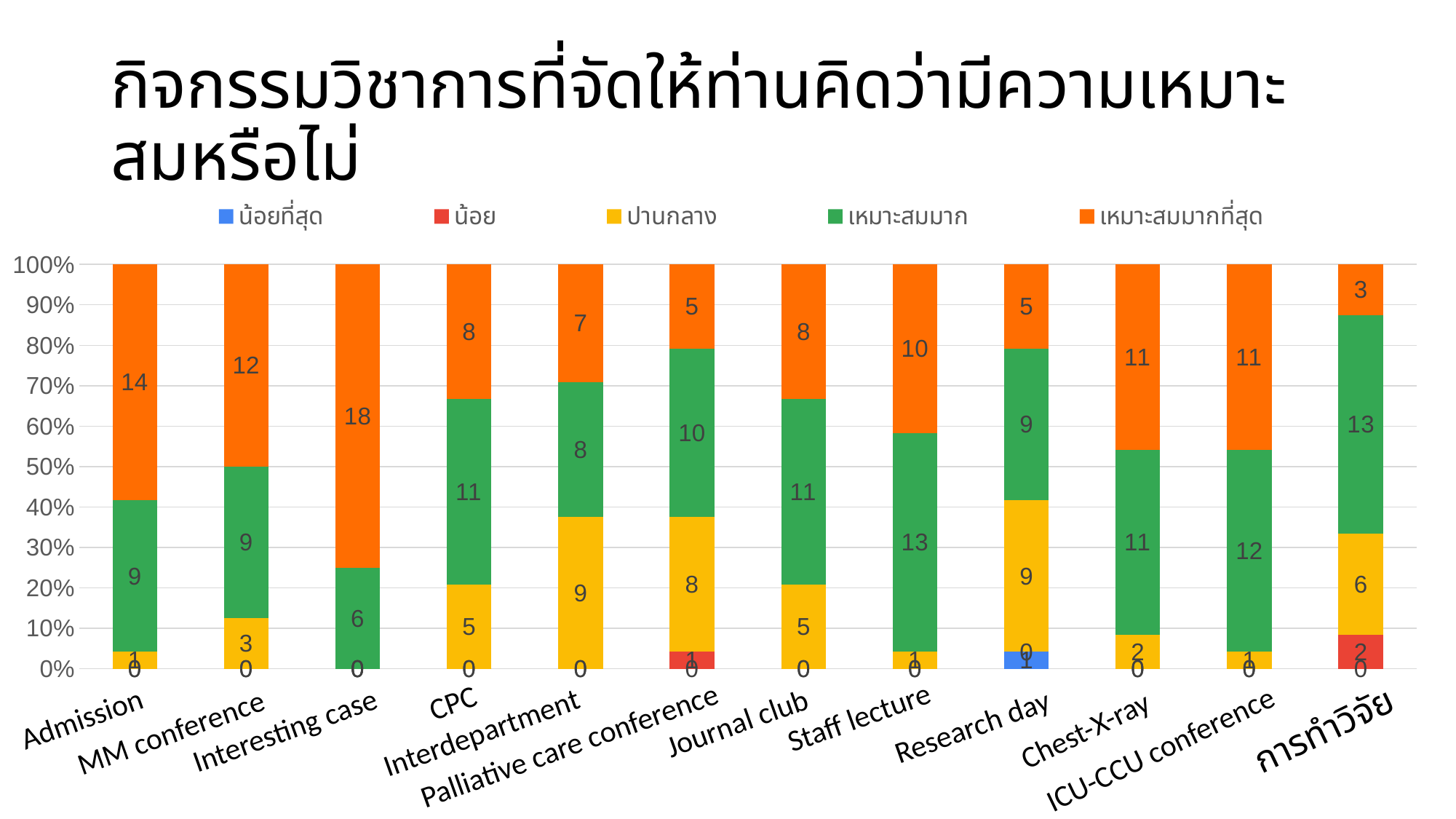
What kind of chart is shown on the slide? stacked bar chart What is the value of the เหมาะสมมากที่สุด (orange) segment for Interesting case? 18 Which is larger: the เหมาะสมมาก (green) value for CPC or for Interdepartment? CPC What is the difference between the เหมาะสมมากที่สุด (orange) values for Admission and MM conference? 2 Which category has the highest value for the เหมาะสมมากที่สุด (orange) series? Interesting case What is the value of the เหมาะสมมาก (green) segment for Staff lecture? 13 How many series does the legend list? 5 What is the value of the ปานกลาง (yellow) segment for Research day? 9 What is the value of the เหมาะสมมากที่สุด (orange) segment for การทำวิจัย? 3 How many categories are shown along the x axis? 12 Which legend entry is shown in orange? เหมาะสมมากที่สุด What is the total of the labelled segments in the Chest-X-ray bar? 24